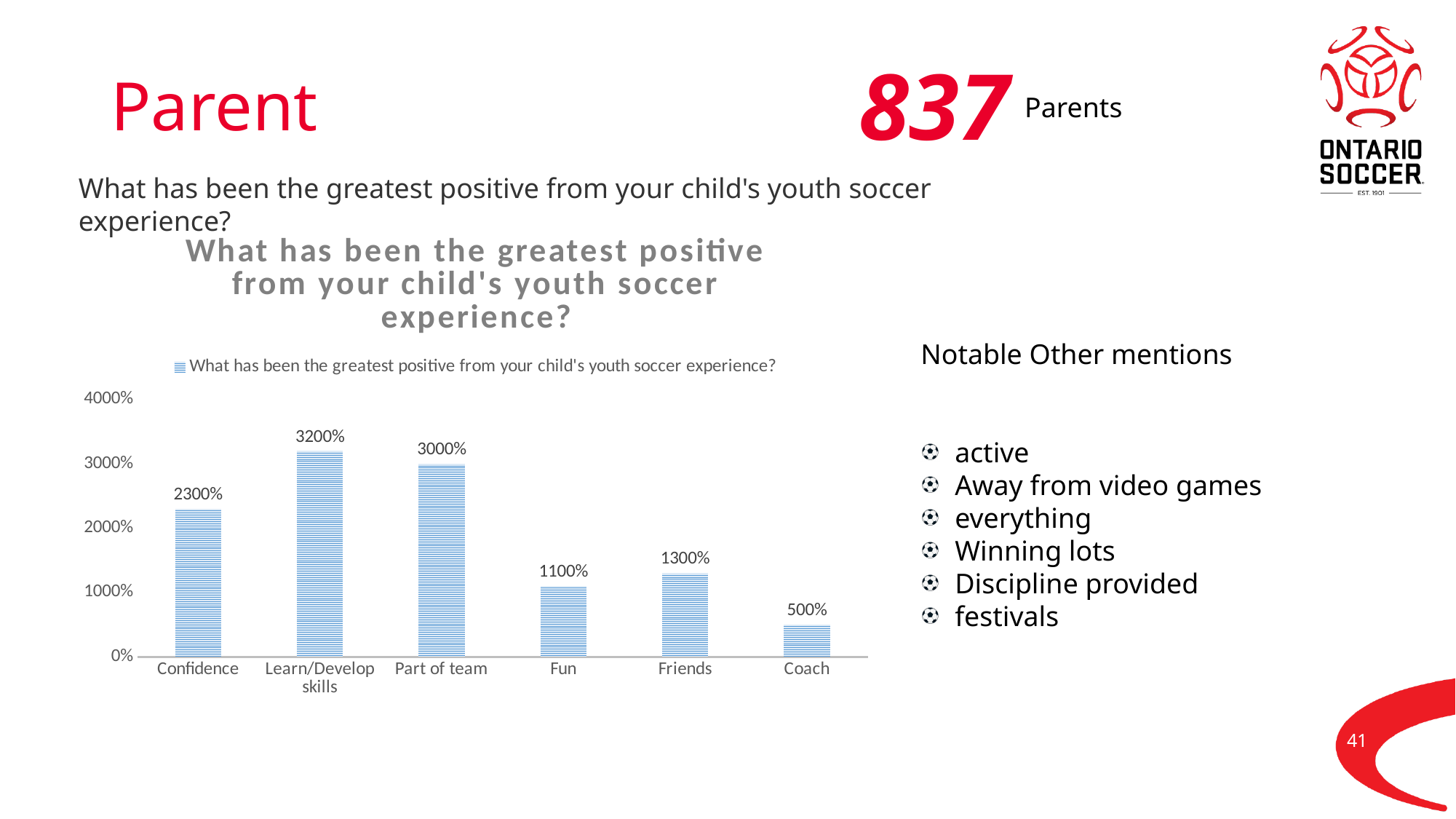
What is the value for Fun? 1100% What kind of chart is shown on the slide? bar chart What is the value for Confidence? 2300% How many series does the legend list? 1 Which category has the lowest value? Coach What is the difference between the values for Friends and Fun? 200% Which category has the highest value? Learn/Develop skills How many categories are shown on the x axis? 6 What is the difference between the values for Learn/Develop skills and Part of team? 200% What is the value for Coach? 500% What is the value for Learn/Develop skills? 3200% Which is larger, the value for Confidence or the value for Friends? Confidence